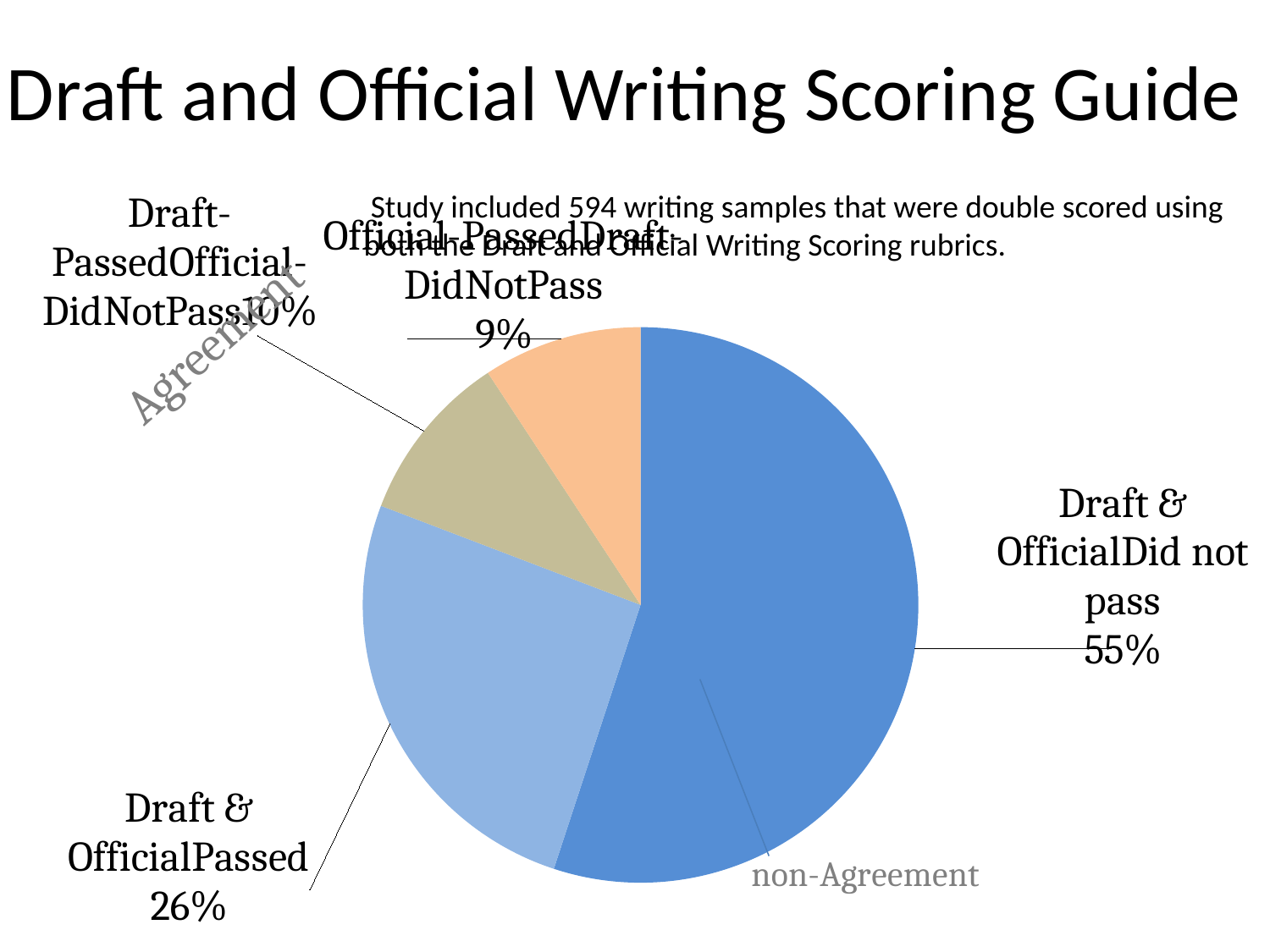
What percentage of the pie is the 'Draft & Official Did not pass' slice? 55% How many slices does the pie chart have? 4 What is the difference in percentage points between the 'Draft & Official Did not pass' slice and the 'Draft & Official Passed' slice? 29 What percentage of the pie is the 'Official-Passed Draft-DidNotPass' slice? 9% Which is larger, the 'Draft & Official Passed' slice or the 'Draft-Passed Official-DidNotPass' slice? Draft & Official Passed What percentage of the pie is the 'Draft & Official Passed' slice? 26% Which slice of the pie is the largest? Draft & Official Did not pass How many writing samples does the slide say were included in the study? 594 Which slice of the pie is the smallest? Official-Passed Draft-DidNotPass What kind of chart is shown on the slide? pie chart What is the combined percentage of the two 'Agreement' slices ('Draft & Official Did not pass' and 'Draft & Official Passed')? 81% What percentage of the pie is the 'Draft-Passed Official-DidNotPass' slice? 10%